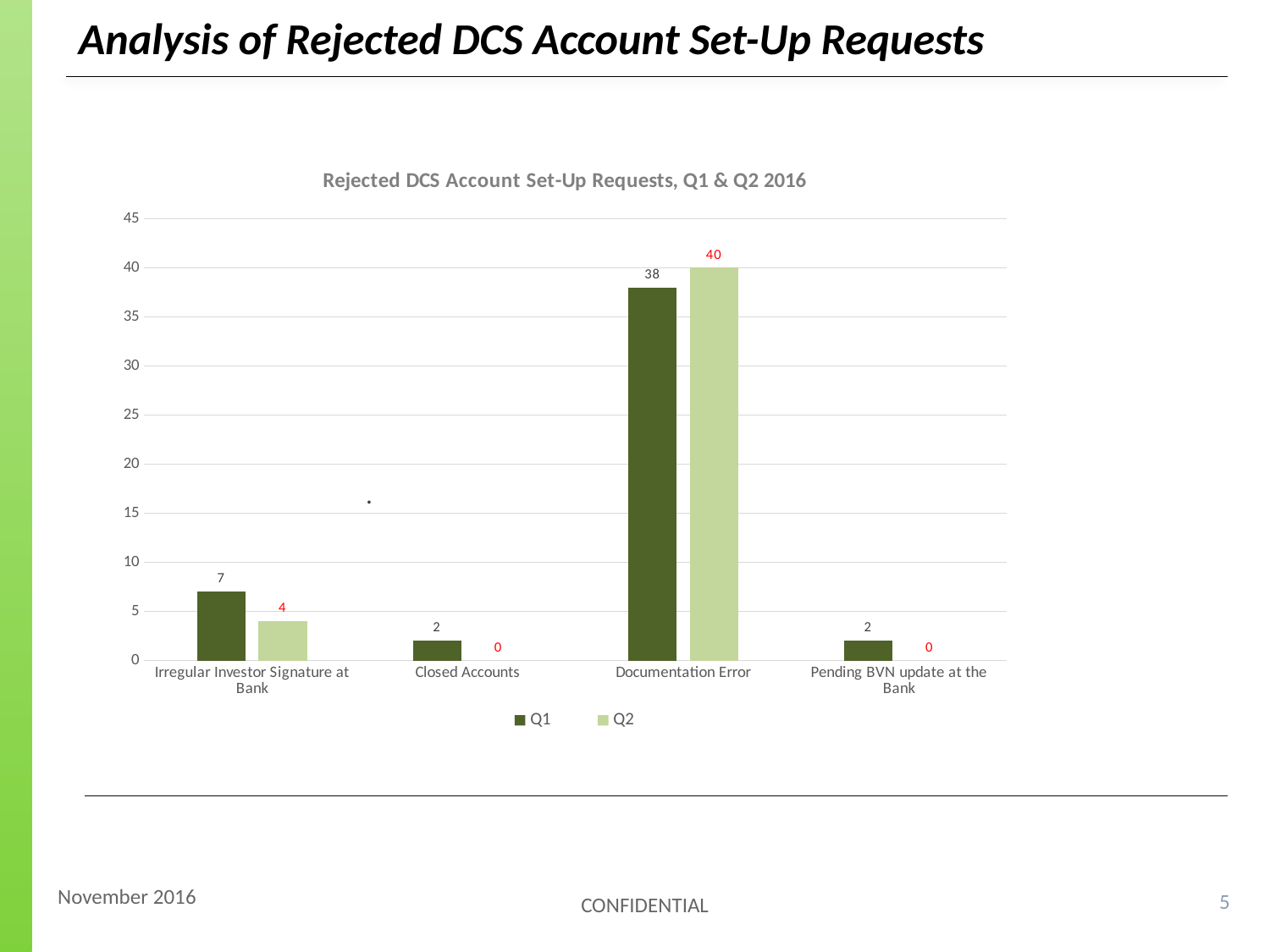
How many series does the legend list? 2 Which is larger for Irregular Investor Signature at Bank, the Q1 value or the Q2 value? Q1 What type of chart is shown on the slide? Bar chart What is the Q1 value for Documentation Error? 38 What is the Q1 value for Pending BVN update at the Bank? 2 What is the Q2 value for Closed Accounts? 0 What is the difference between the Q2 and Q1 values for Documentation Error? 2 Which category has the highest Q2 value? Documentation Error What is the difference between the Q1 and Q2 values for Irregular Investor Signature at Bank? 3 What is the Q2 value for Irregular Investor Signature at Bank? 4 How many categories are shown on the x axis? 4 Which category has the highest Q1 value? Documentation Error